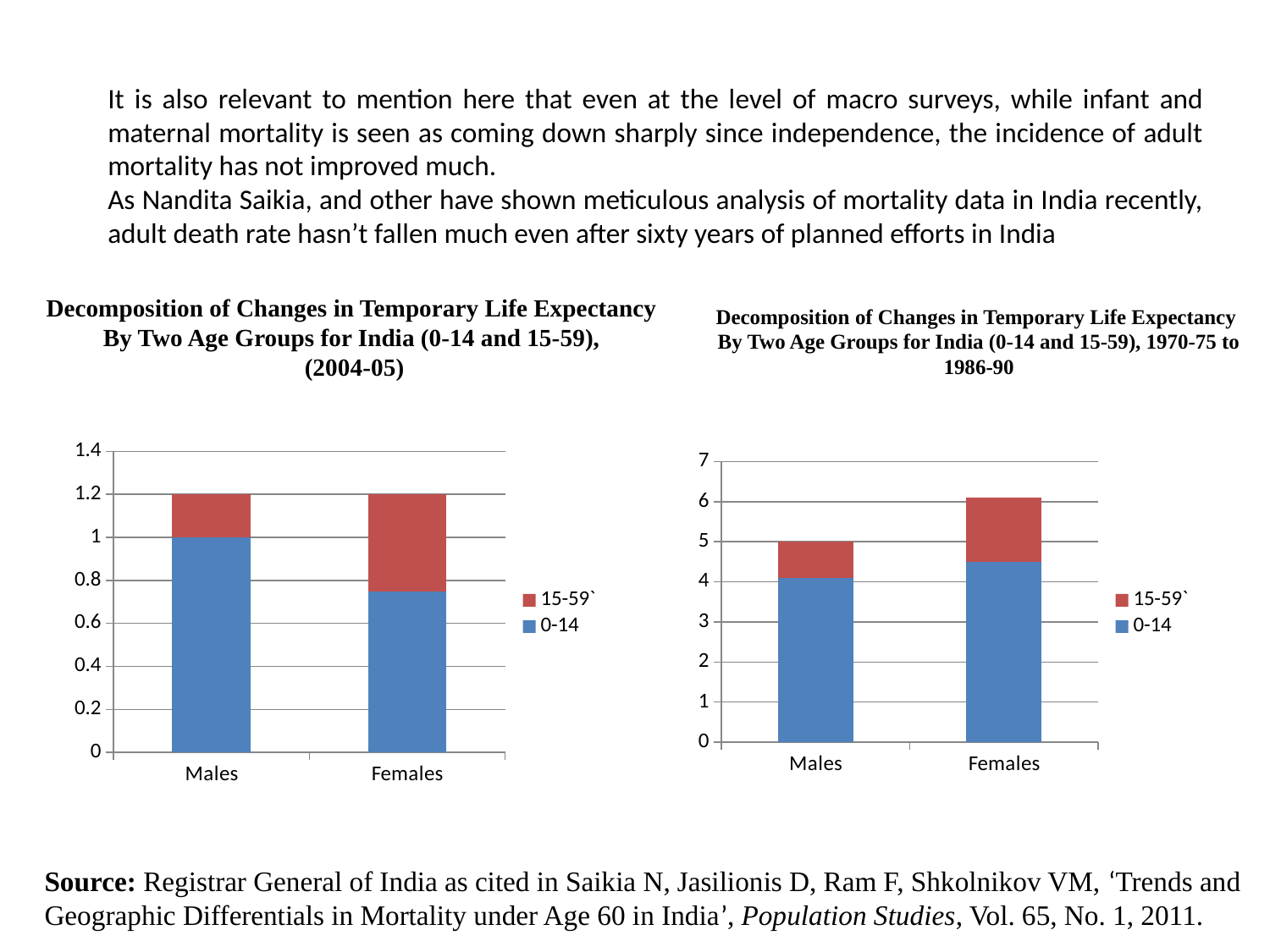
In the left chart (2004-05), is the 0-14 value for Females greater or less than 0.8? less In the left chart (2004-05), what is the total height of the stacked bar for Males? 1.2 What type of chart is the left chart, titled 'Decomposition of Changes in Temporary Life Expectancy By Two Age Groups for India (0-14 and 15-59), (2004-05)'? Stacked bar chart How many series does the legend of the right chart (1970-75 to 1986-90) list? 2 In the right chart (1970-75 to 1986-90), which category has the taller total stacked bar, Males or Females? Females In the right chart (1970-75 to 1986-90), is the 0-14 value for Females greater or less than 4? greater How many categories are shown on the x axis of the left chart (2004-05)? 2 In the right chart (1970-75 to 1986-90), what is the total height of the stacked bar for Males? 5 In the left chart (2004-05), which category has the larger 0-14 segment, Males or Females? Males Which colour represents the 0-14 age group in both charts? Blue In the left chart (2004-05), what is the value of the 0-14 segment for Males? 1